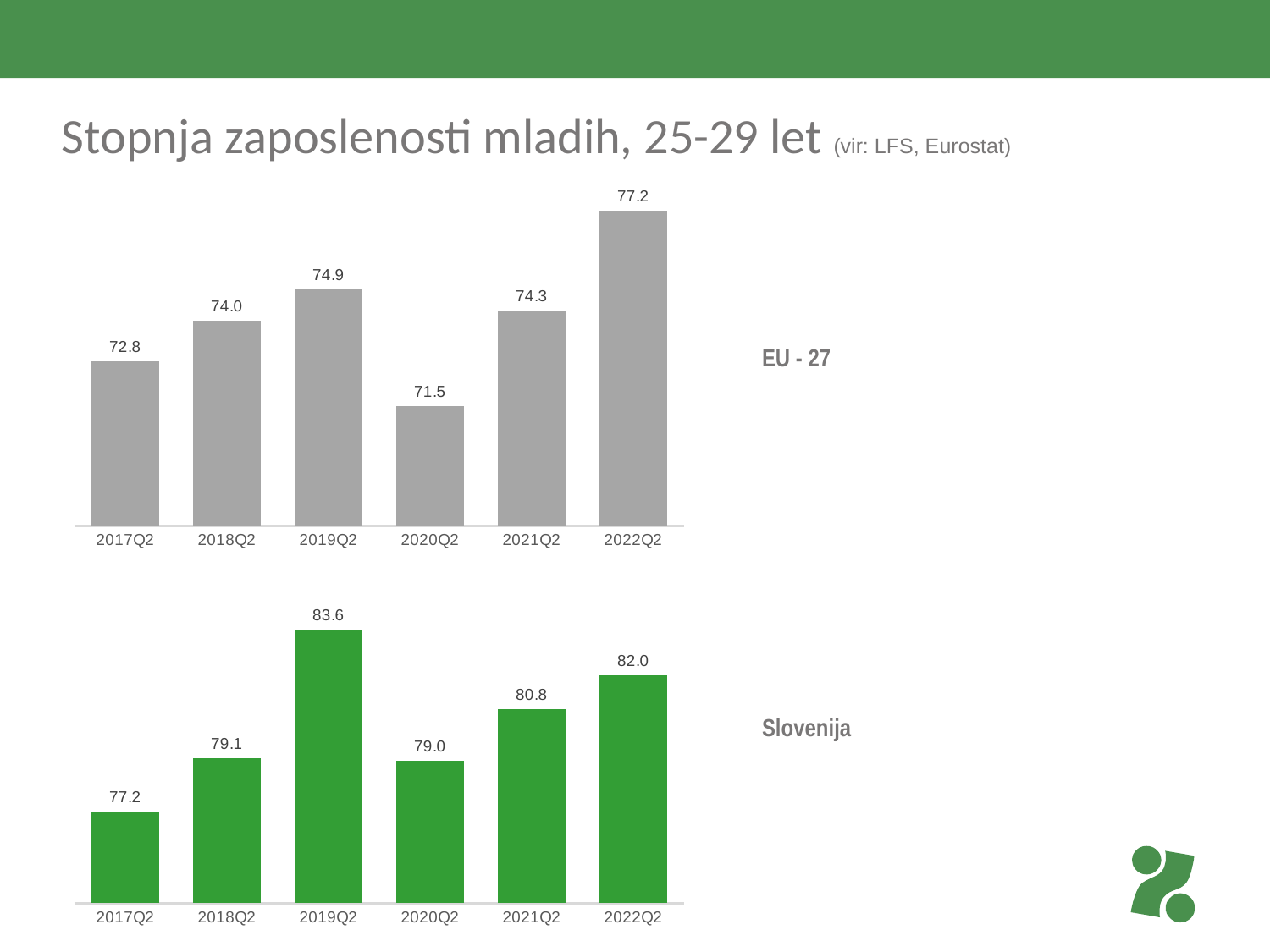
In the EU - 27 chart, does the value rise or fall from 2019Q2 to 2020Q2? fall In the Slovenija chart, which is larger, the value for 2021Q2 or the value for 2022Q2? 2022Q2 How many bars are in the EU - 27 chart? 6 In the EU - 27 chart, which is larger, the value for 2018Q2 or the value for 2019Q2? 2019Q2 What colour are the bars in the Slovenija chart? green In the EU - 27 chart, what is the difference between the values for 2022Q2 and 2020Q2? 5.7 What kind of chart is the Slovenija chart? bar chart In the EU - 27 chart, which quarter has the highest value? 2022Q2 In the EU - 27 chart, what is the value for 2020Q2? 71.5 In the Slovenija chart, what is the value for 2019Q2? 83.6 In the Slovenija chart, what is the difference between the values for 2019Q2 and 2020Q2? 4.6 In the Slovenija chart, which quarter has the lowest value? 2017Q2